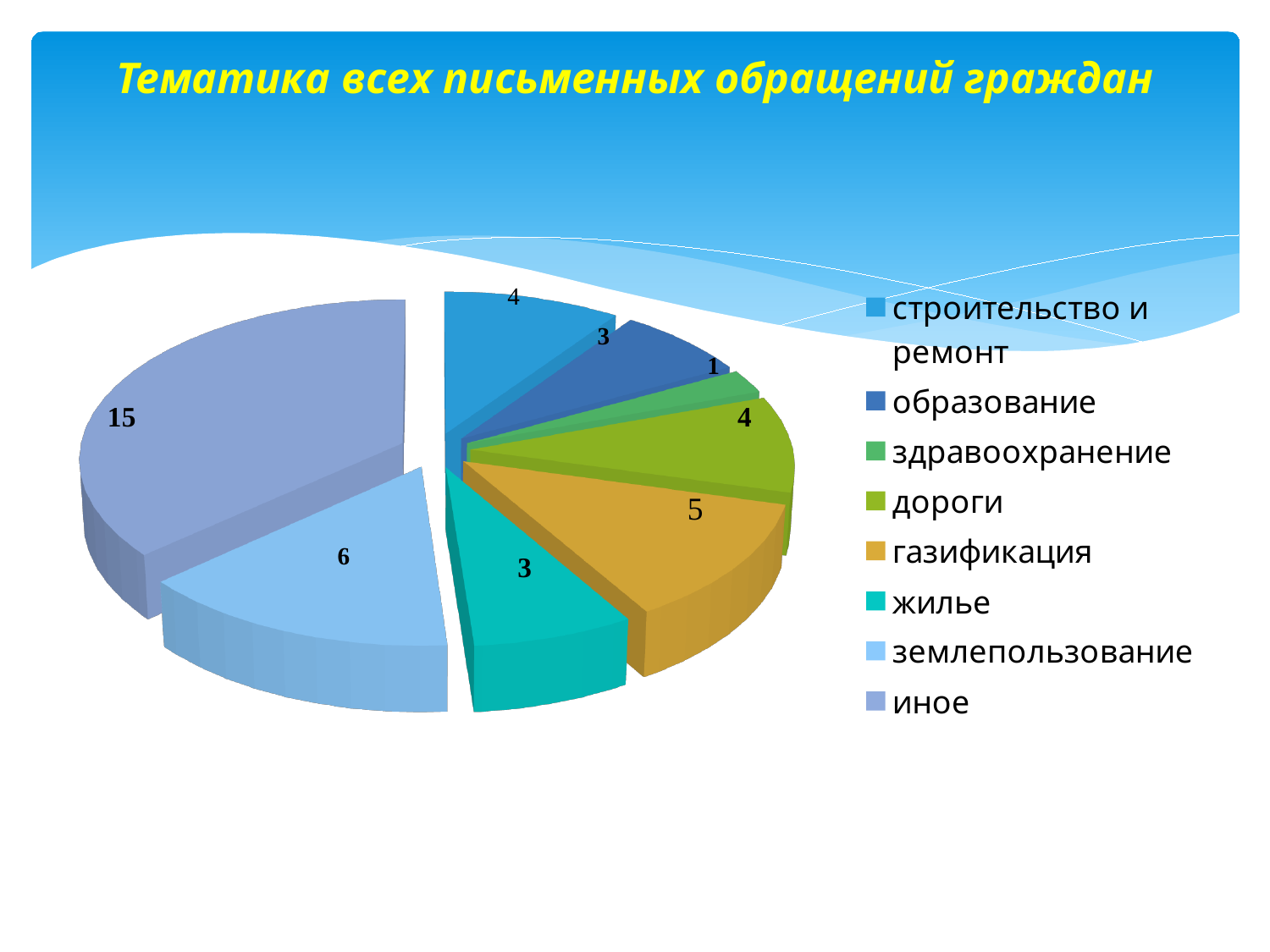
What is the value for the category "газификация"? 5 What is the value for the category "здравоохранение"? 1 Which category has the highest value in the pie chart? иное What is the sum of all the values shown in the pie chart? 41 How many categories does the pie chart show? 8 What kind of chart is shown on the slide? pie chart What is the difference between the values for "иное" and "землепользование"? 9 Which has a larger value, "газификация" or "дороги"? газификация What is the value for the category "иное"? 15 Which category has the lowest value in the pie chart? здравоохранение What is the title of the slide? Тематика всех письменных обращений граждан What is the value for the category "землепользование"? 6